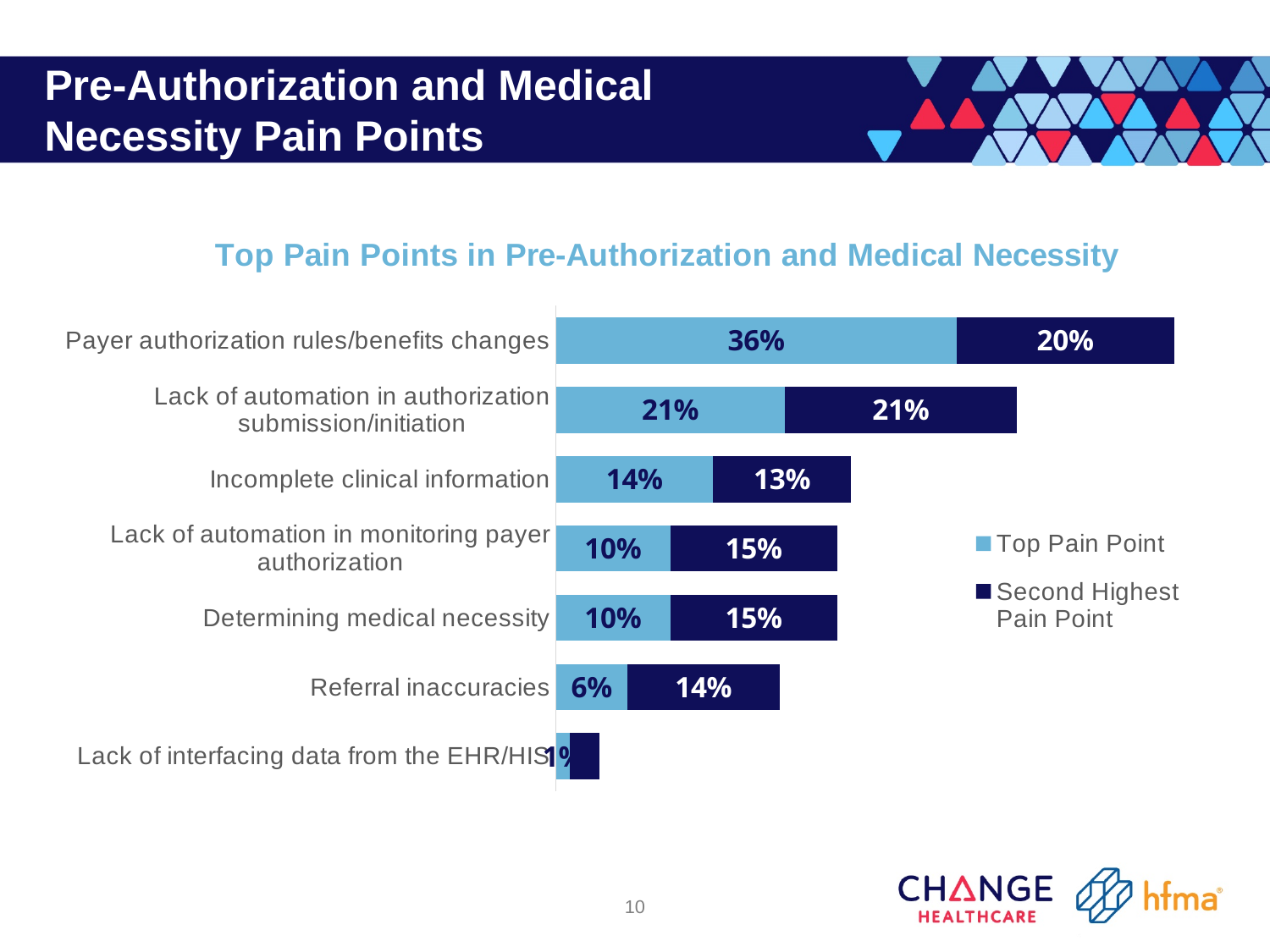
What is the Second Highest Pain Point value for Referral inaccuracies? 14% What is the difference between the Top Pain Point values for Payer authorization rules/benefits changes and Lack of automation in authorization submission/initiation? 15% What type of chart is shown on the slide? Stacked bar chart Which is larger: the Top Pain Point value for Referral inaccuracies or the Second Highest Pain Point value for Referral inaccuracies? Second Highest Pain Point How many series does the legend list? 2 What is the total of the stacked bar for Lack of automation in authorization submission/initiation? 42% What is the Top Pain Point value for Payer authorization rules/benefits changes? 36% How many categories are shown in the chart? 7 What is the title of the chart? Top Pain Points in Pre-Authorization and Medical Necessity What is the Second Highest Pain Point value for Incomplete clinical information? 13% Which category has the highest Top Pain Point value? Payer authorization rules/benefits changes Which category has the lowest Top Pain Point value? Lack of interfacing data from the EHR/HIS